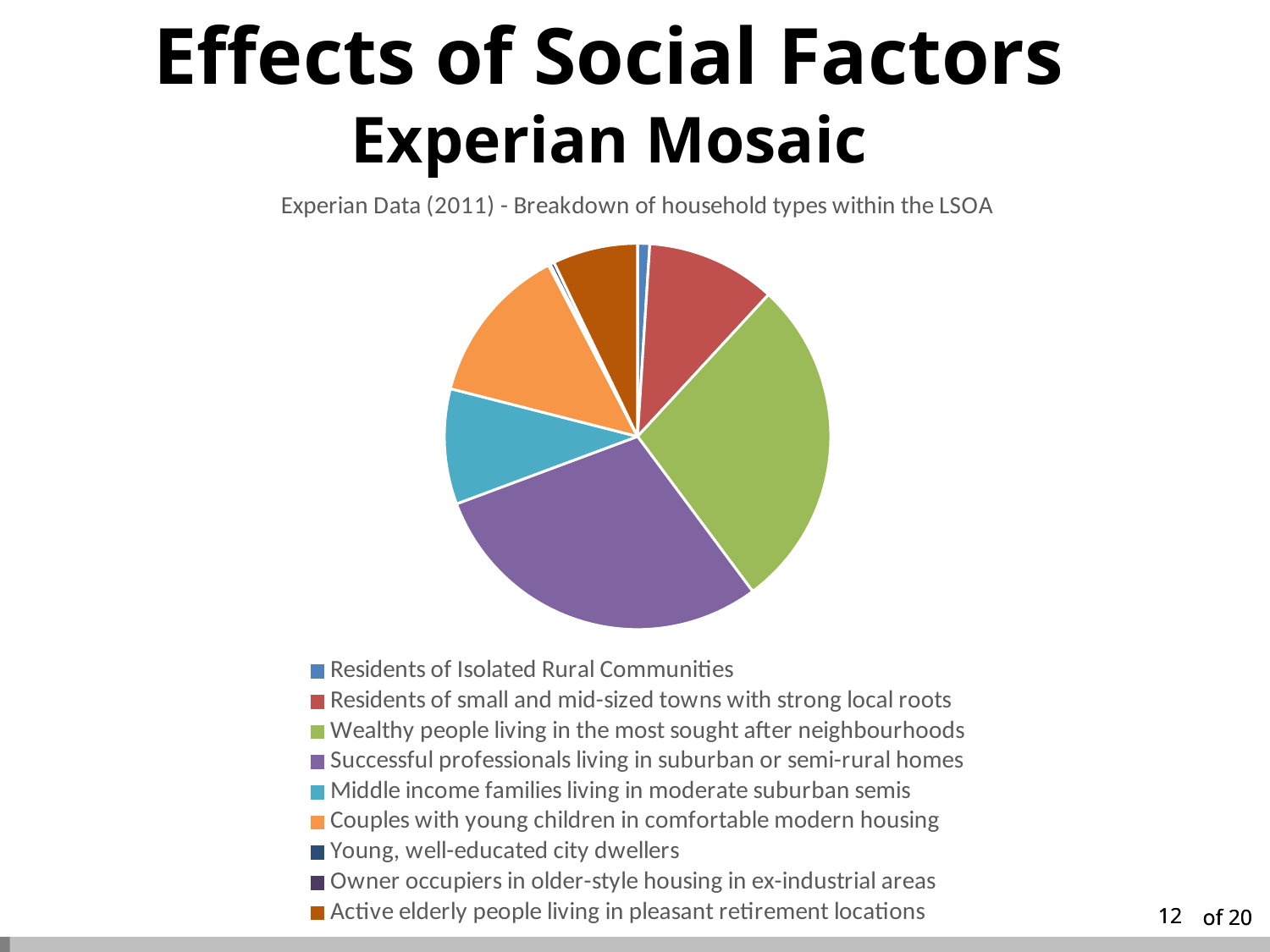
Which slice is larger: 'Residents of Isolated Rural Communities' or 'Residents of small and mid-sized towns with strong local roots'? Residents of small and mid-sized towns with strong local roots Which colour represents 'Wealthy people living in the most sought after neighbourhoods' in the pie chart? green What is the title of the pie chart? Experian Data (2011) - Breakdown of household types within the LSOA Which slice is larger: 'Wealthy people living in the most sought after neighbourhoods' or 'Residents of small and mid-sized towns with strong local roots'? Wealthy people living in the most sought after neighbourhoods Which slice is larger: 'Residents of small and mid-sized towns with strong local roots' or 'Active elderly people living in pleasant retirement locations'? Residents of small and mid-sized towns with strong local roots How many slices does the pie chart break the household types into? 9 How many household types does the legend of the pie chart list? 9 What kind of chart is shown on the slide? pie chart